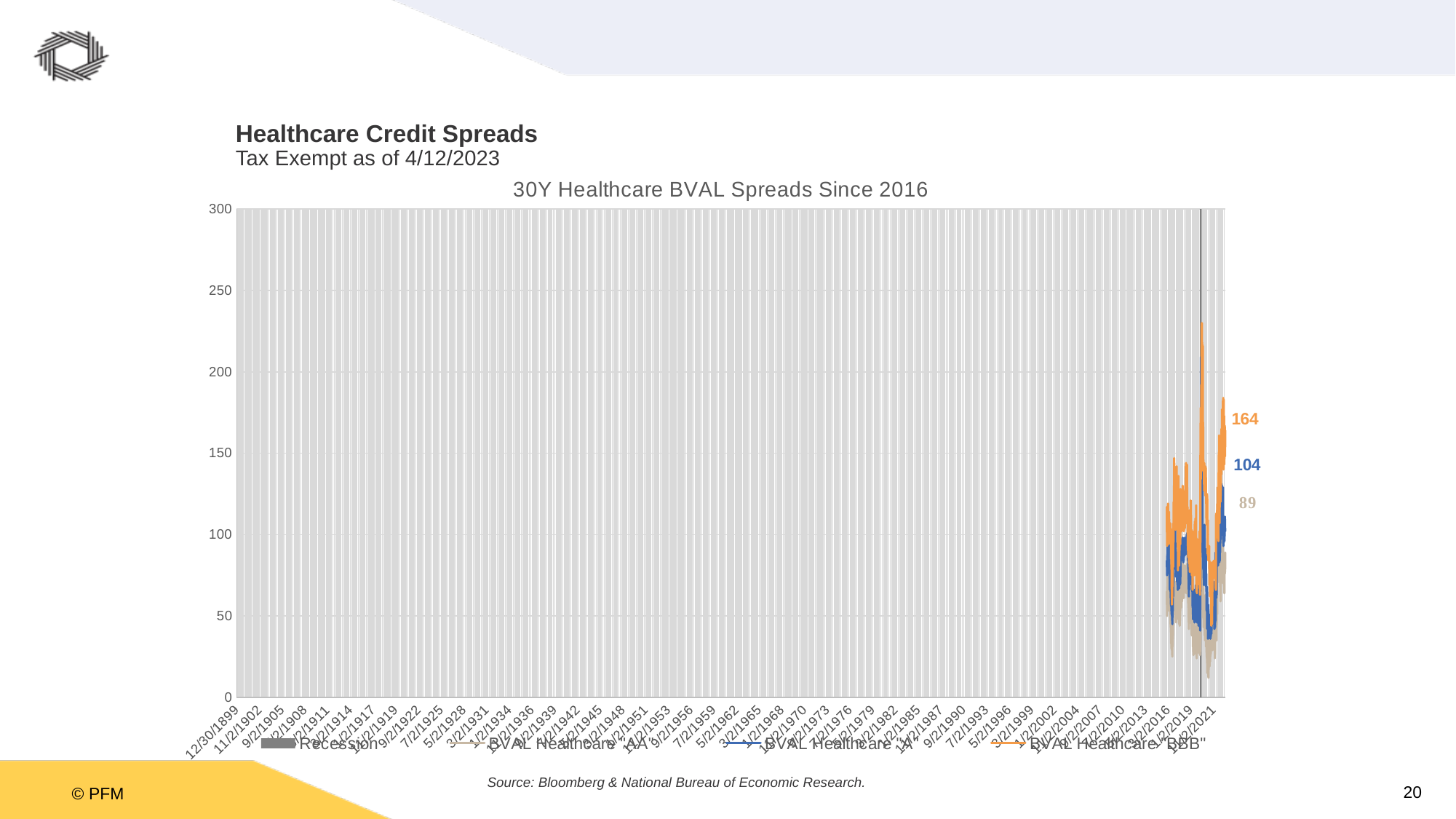
Which is larger, the labelled end value for BVAL Healthcare "A" or for BVAL Healthcare "AA"? BVAL Healthcare "A" Which series has the lowest labelled end value? BVAL Healthcare "AA" What is the latest labelled value for BVAL Healthcare "BBB"? 164 What is the title of the chart? 30Y Healthcare BVAL Spreads Since 2016 What kind of chart is shown? Line chart What is the latest labelled value for BVAL Healthcare "AA"? 89 Which series has the highest labelled end value? BVAL Healthcare "BBB" What is the latest labelled value for BVAL Healthcare "A"? 104 What is the difference between the labelled end values for BVAL Healthcare "BBB" and BVAL Healthcare "A"? 60 How many entries does the legend list? 4 What is the difference between the labelled end values for BVAL Healthcare "A" and BVAL Healthcare "AA"? 15 Is the peak value of the BVAL Healthcare "BBB" line greater or less than 200? greater